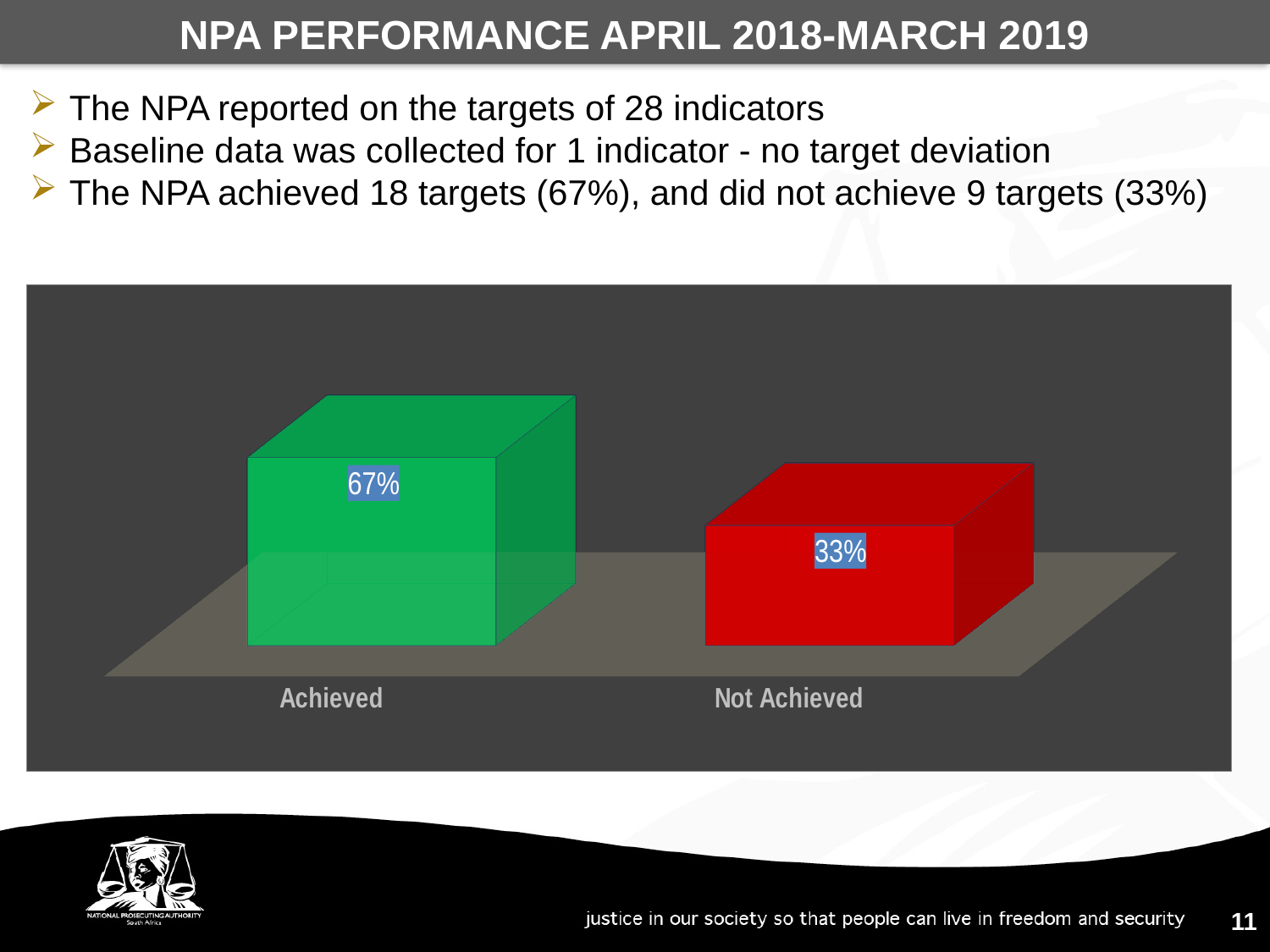
Which category has the highest value? Achieved What is the total of the Achieved and Not Achieved values? 100% What kind of chart is shown on the slide? Bar chart What colour is the Achieved bar? Green Which category has the lowest value? Not Achieved What is the value for Achieved? 67% How many categories are shown in the chart? 2 Which is larger, Achieved or Not Achieved? Achieved What colour is the Not Achieved bar? Red What is the value for Not Achieved? 33% What is the difference between the Achieved and Not Achieved values? 34%